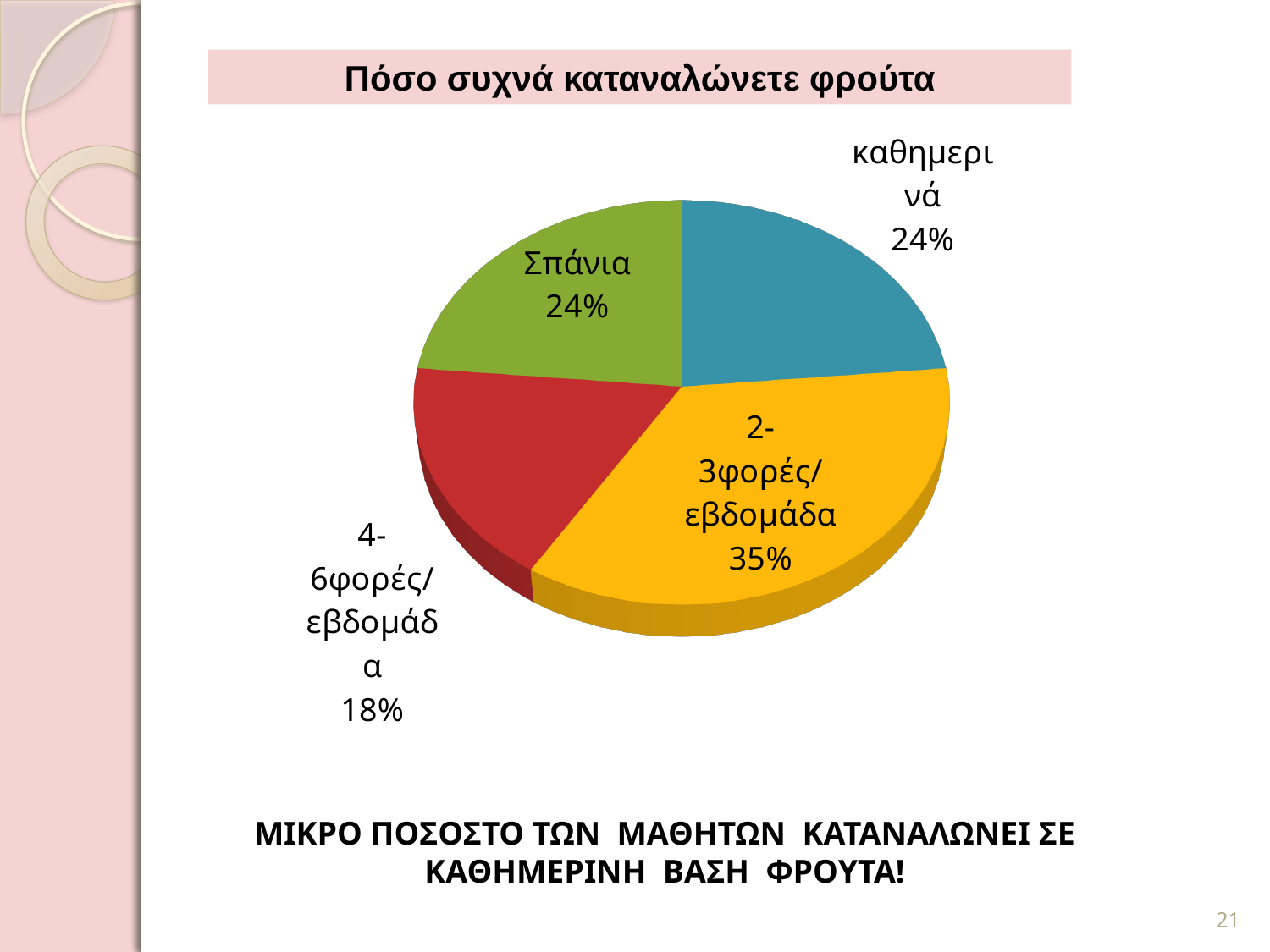
What is the title of the chart? Πόσο συχνά καταναλώνετε φρούτα What percentage of students answered '4-6φορές/εβδομάδα'? 18% What percentage of students answered 'Σπάνια'? 24% What colour is the slice for '2-3φορές/εβδομάδα'? Yellow What type of chart is shown on the slide? Pie chart What is the difference in percentage points between '2-3φορές/εβδομάδα' and '4-6φορές/εβδομάδα'? 17 Which category has the smallest share of the pie? 4-6φορές/εβδομάδα What percentage of students answered 'καθημερινά'? 24% Which category has the largest share of the pie? 2-3φορές/εβδομάδα How many categories are shown in the pie chart? 4 Which is larger: the share for '2-3φορές/εβδομάδα' or the share for 'καθημερινά'? 2-3φορές/εβδομάδα What percentage of students answered '2-3φορές/εβδομάδα'? 35%